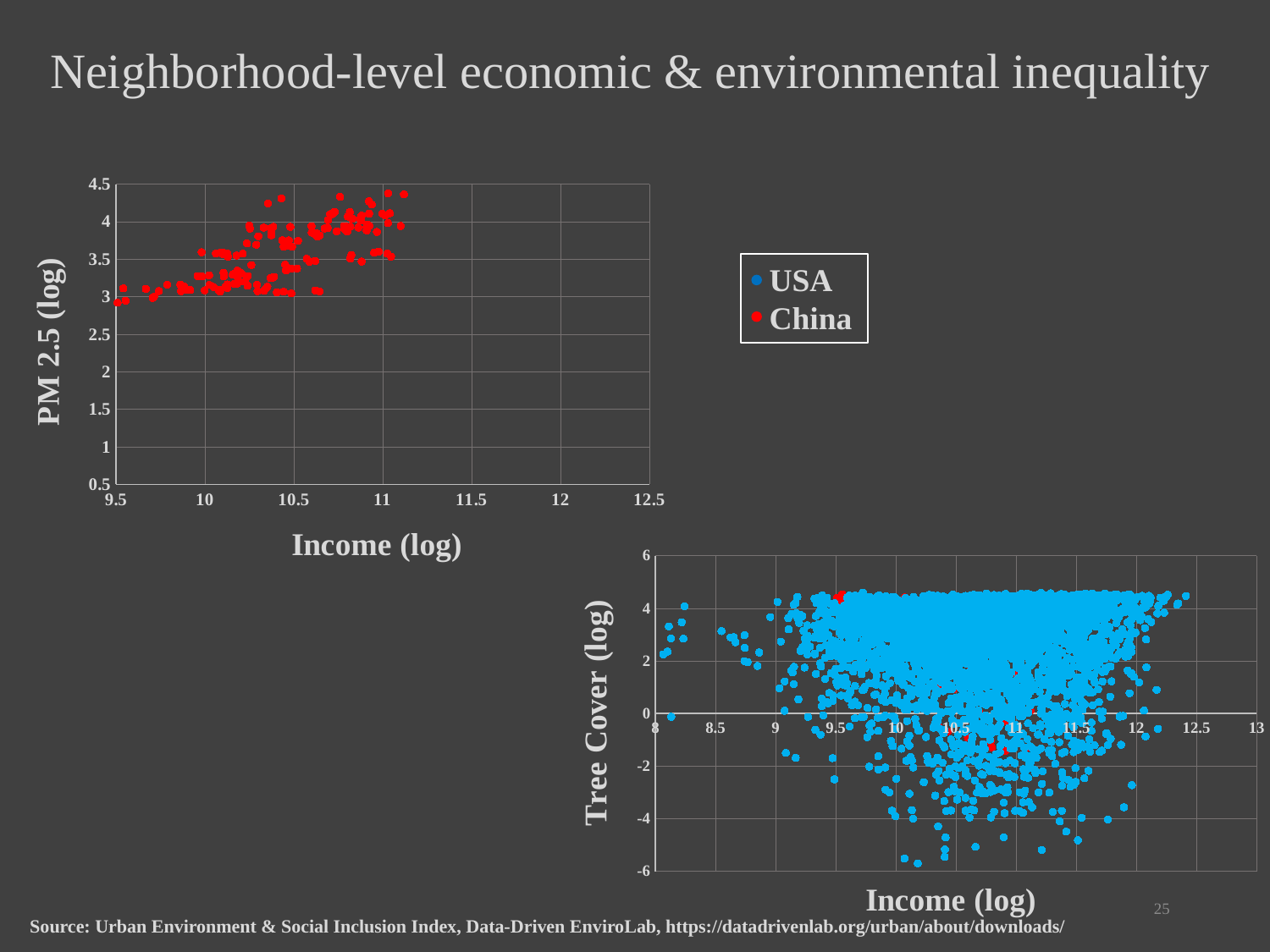
In the top-left chart, what is the label of the y axis? PM 2.5 (log) In the bottom-right chart, what is the label of the y axis? Tree Cover (log) In the top-left chart, are the plotted PM 2.5 (log) values greater or less than 4.5? Less In the top-left chart, are the plotted PM 2.5 (log) values greater or less than 2.5? Greater In the bottom-right chart, what is the lowest value shown on the x axis? 8 What kind of chart is the bottom-right chart on the slide? Scatter chart In the top-left chart, do the PM 2.5 (log) values generally rise or fall as Income (log) increases? Rise What kind of chart is the top-left chart on the slide? Scatter chart Which two series are listed in the legend? USA and China In the bottom-right chart, what is the highest value shown on the y axis? 6 How many series does the legend list? 2 What colour represents China in the legend? Red